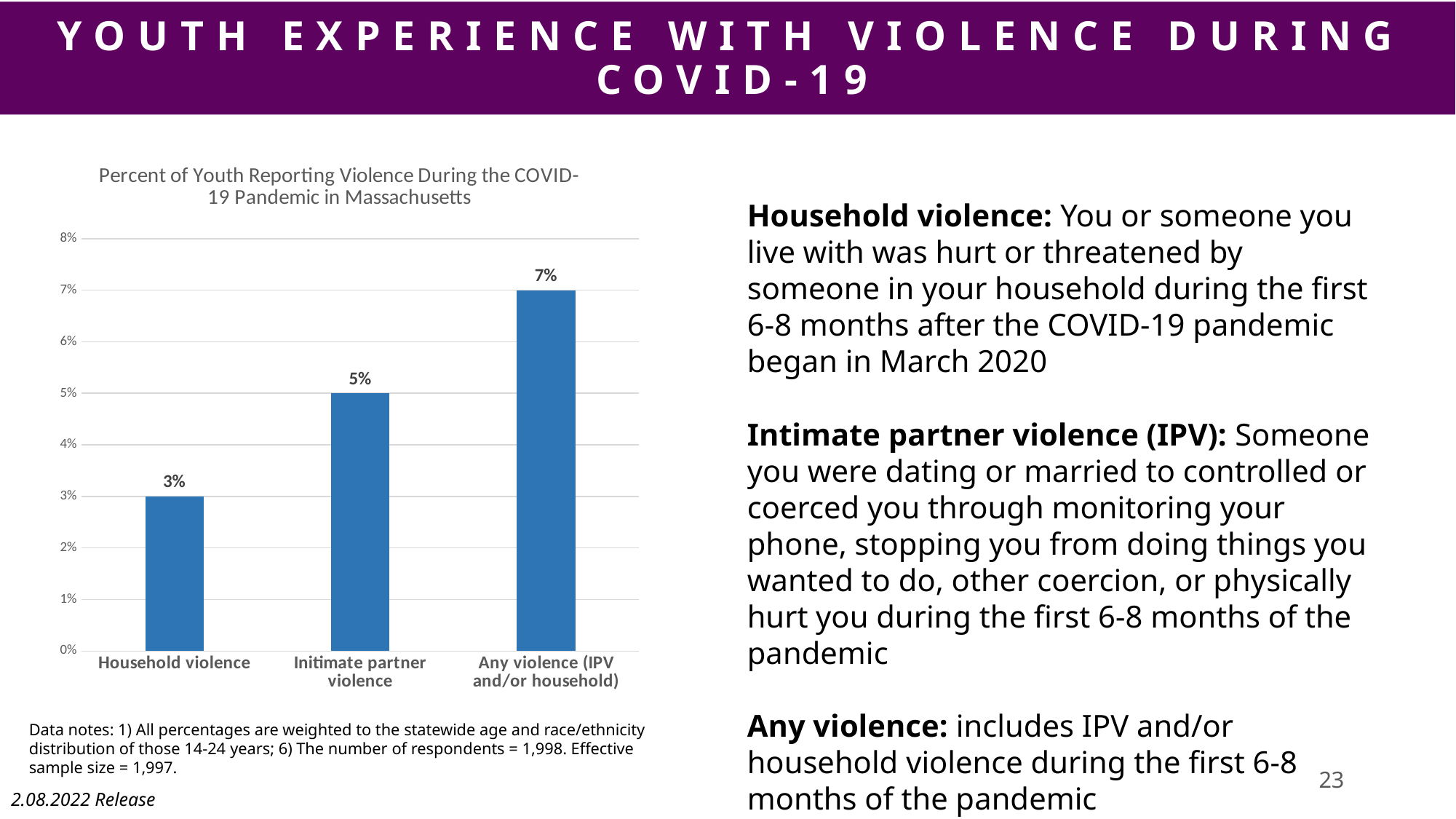
What is the difference in percentage points between intimate partner violence and household violence? 2 What kind of chart is shown on the slide? Bar chart What percent of youth reported intimate partner violence? 5% What is the difference in percentage points between any violence and household violence? 4 Which is larger, the percentage for intimate partner violence or for household violence? Intimate partner violence What percent of youth reported any violence (IPV and/or household)? 7% What is the title of the chart? Percent of Youth Reporting Violence During the COVID-19 Pandemic in Massachusetts What percent of youth reported household violence? 3% How many categories are shown in the chart? 3 Which category has the lowest percentage? Household violence Is the value for any violence (IPV and/or household) greater or less than 6%? greater Which category has the highest percentage? Any violence (IPV and/or household)